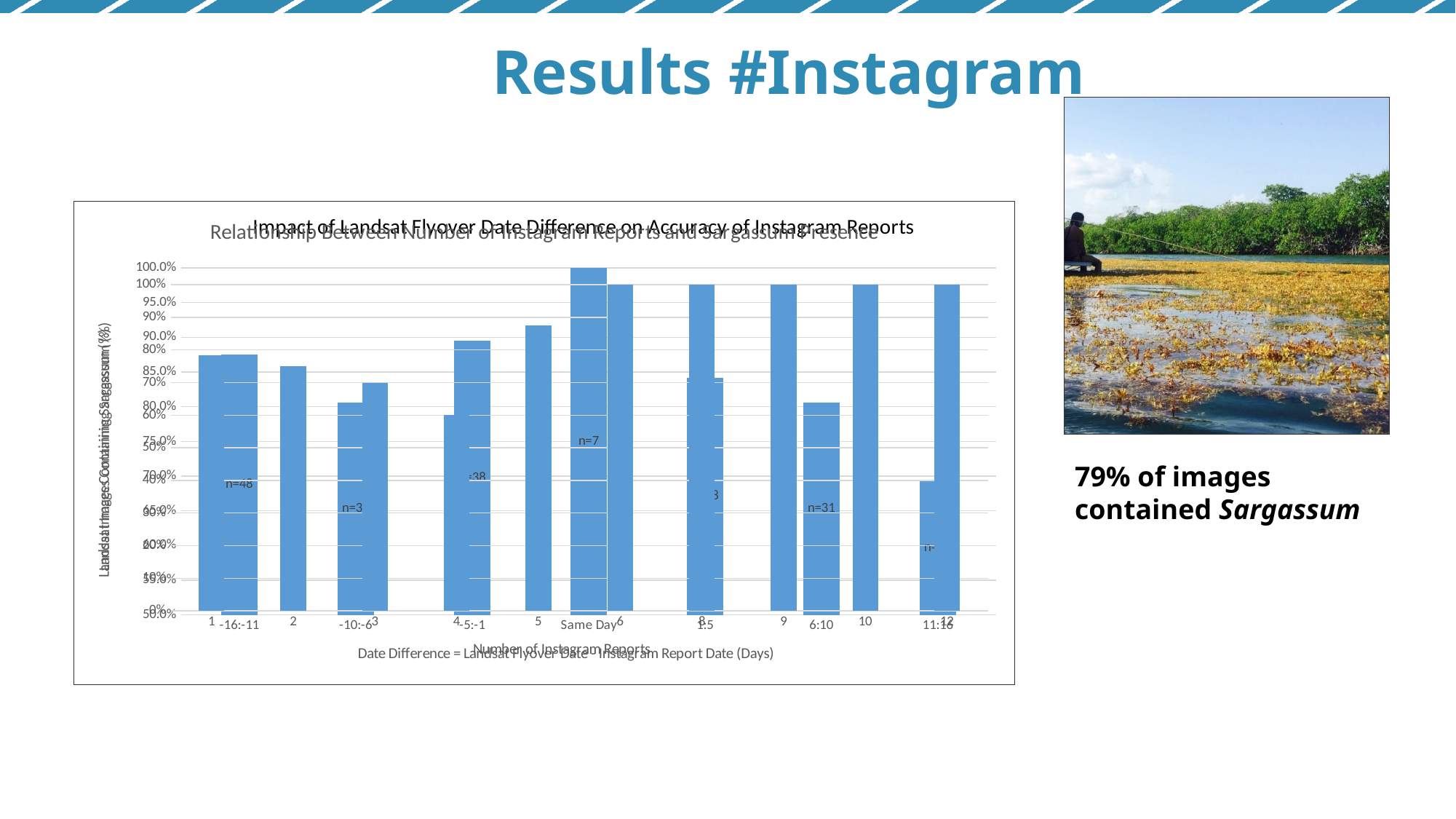
In the chart titled 'Impact of Landsat Flyover Date Difference on Accuracy of Instagram Reports', what sample-size label is printed on the '6:10' bar? n=31 What kind of chart is shown on the slide? bar chart In the chart titled 'Impact of Landsat Flyover Date Difference on Accuracy of Instagram Reports', what is the x-axis label? Date Difference = Landsat Flyover Date - Instagram Report Date (Days) In the chart titled 'Relationship Between Number of Instagram Reports and Sargassum Presence', how many categories are shown on the x axis? 10 In the chart titled 'Impact of Landsat Flyover Date Difference on Accuracy of Instagram Reports', how many date-difference categories are shown on the x axis? 7 In the chart titled 'Relationship Between Number of Instagram Reports and Sargassum Presence', what is the x-axis label? Number of Instagram Reports In the chart titled 'Impact of Landsat Flyover Date Difference on Accuracy of Instagram Reports', what sample-size label is printed on the 'Same Day' bar? n=7